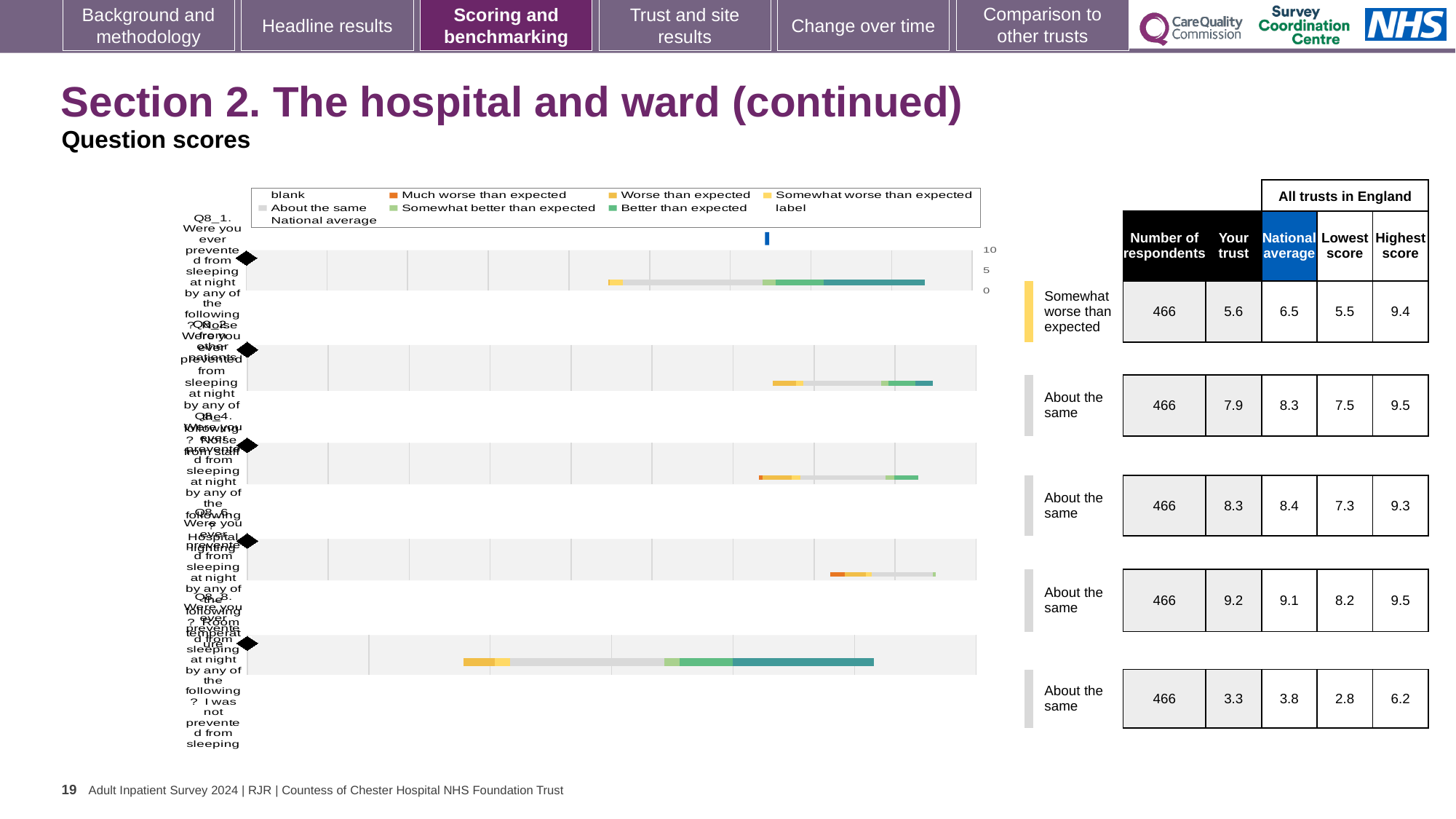
For the fourth question (Q8_6), is the 'Your trust' score or the national average higher? Your trust (9.2) Which question has the highest 'Your trust' score? Q8_6 (fourth bar), 9.2 What is the difference between the national average and the 'Your trust' score for the first question (Q8_1)? 0.9 What benchmark category is the first question (Q8_1) assigned to? Somewhat worse than expected How many question bars are plotted in the chart? 5 How many respondents are shown for each question in the chart? 466 What kind of chart is used to show the question scores on this slide? bar chart Which question has the lowest 'Your trust' score? Q8_8 (fifth bar), 3.3 What is the 'Your trust' score for the last question (Q8_8) in the chart? 3.3 What is the 'Your trust' score for the first question (Q8_1) in the chart? 5.6 What is the highest score among all trusts in England for the second question (Q8_2)? 9.5 What is the national average for the first question (Q8_1)? 6.5